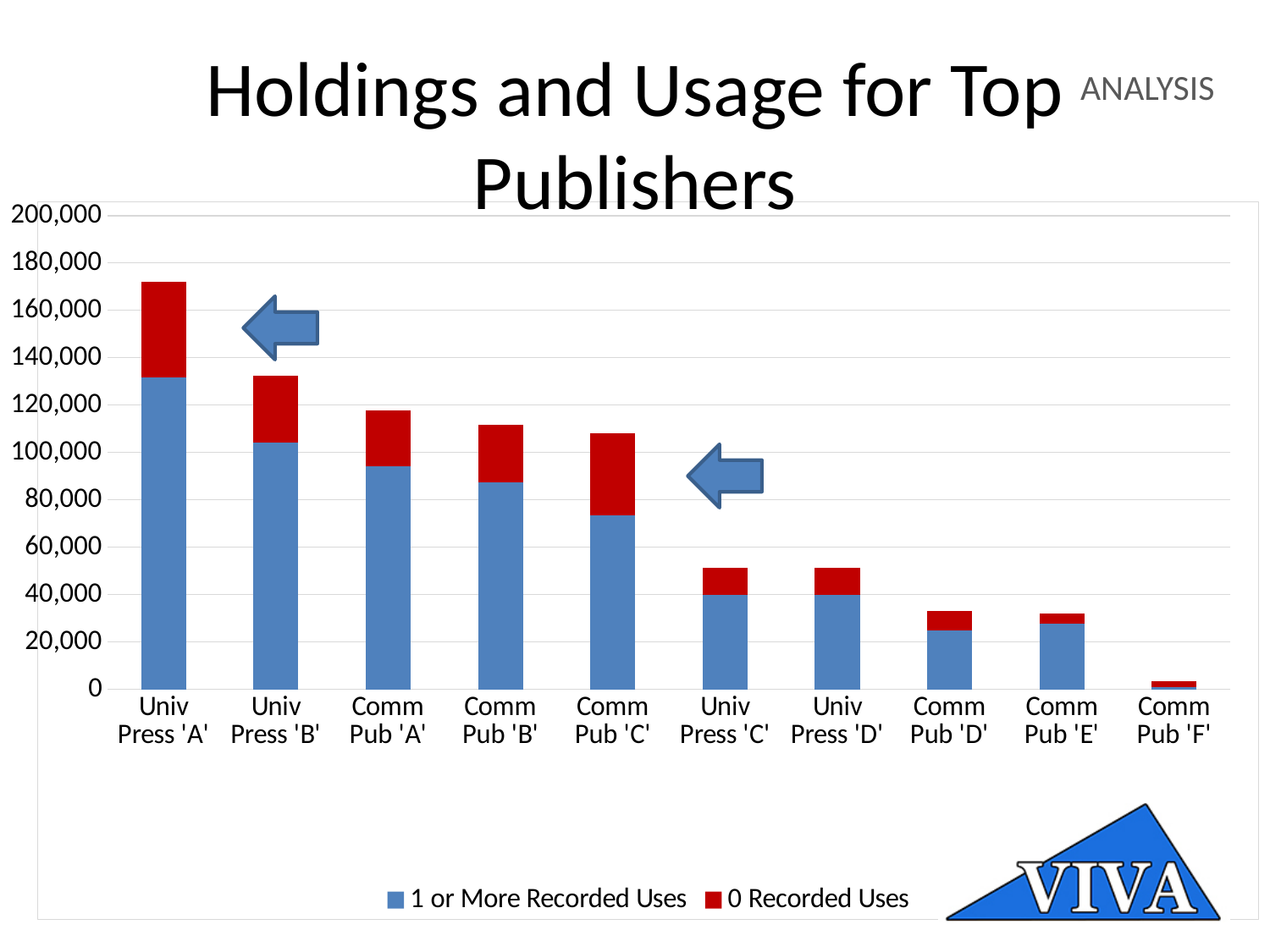
Which series is shown in red in the chart? 0 Recorded Uses Which has the larger '0 Recorded Uses' segment, Comm Pub 'C' or Comm Pub 'E'? Comm Pub 'C' What kind of chart is shown on the slide? Stacked bar chart Is the total bar for Comm Pub 'F' greater or less than 20,000? less Is the total bar for Univ Press 'C' greater or less than 40,000? greater Is the '1 or More Recorded Uses' value for Comm Pub 'C' greater or less than 80,000? less How many publishers are shown on the x axis of the chart? 10 Which publisher has the tallest total bar in the chart? Univ Press 'A' Do the total bar heights generally rise or fall from left to right across the x axis? fall Which publisher has the shortest total bar in the chart? Comm Pub 'F' How many series does the chart's legend list? 2